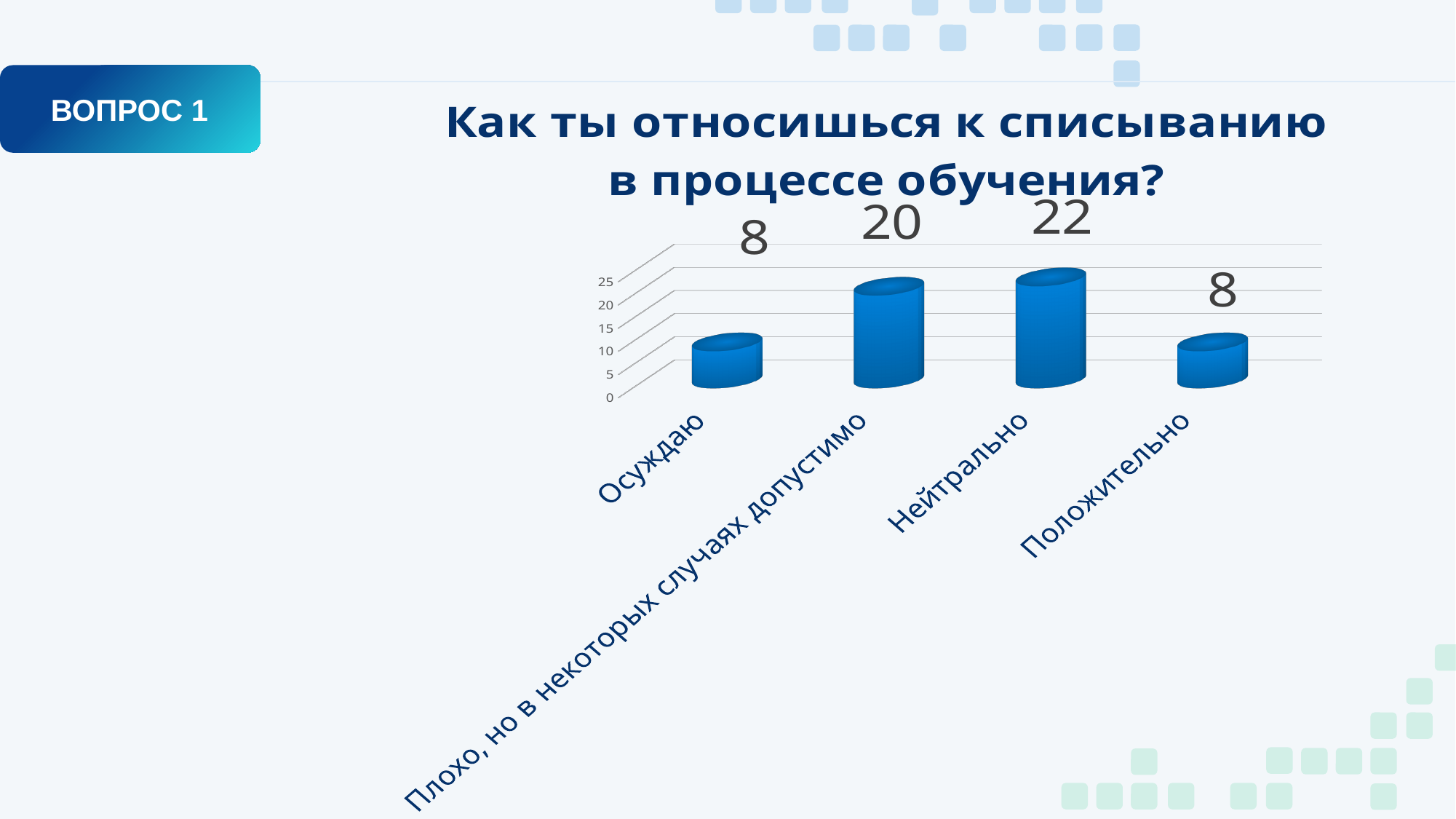
What is the difference between the values for Плохо, но в некоторых случаях допустимо and Осуждаю? 12 What is the value for Нейтрально? 22 Which category has the highest value? Нейтрально How many categories are shown in the chart? 4 What is the value for Осуждаю? 8 What is the value for Плохо, но в некоторых случаях допустимо? 20 What is the difference between the values for Нейтрально and Плохо, но в некоторых случаях допустимо? 2 What is the value for Положительно? 8 What kind of chart is shown on the slide? bar chart Is the value for Нейтрально greater or less than 15? greater Which is larger, the value for Нейтрально or the value for Положительно? Нейтрально What is the title of the chart? Как ты относишься к списыванию в процессе обучения?